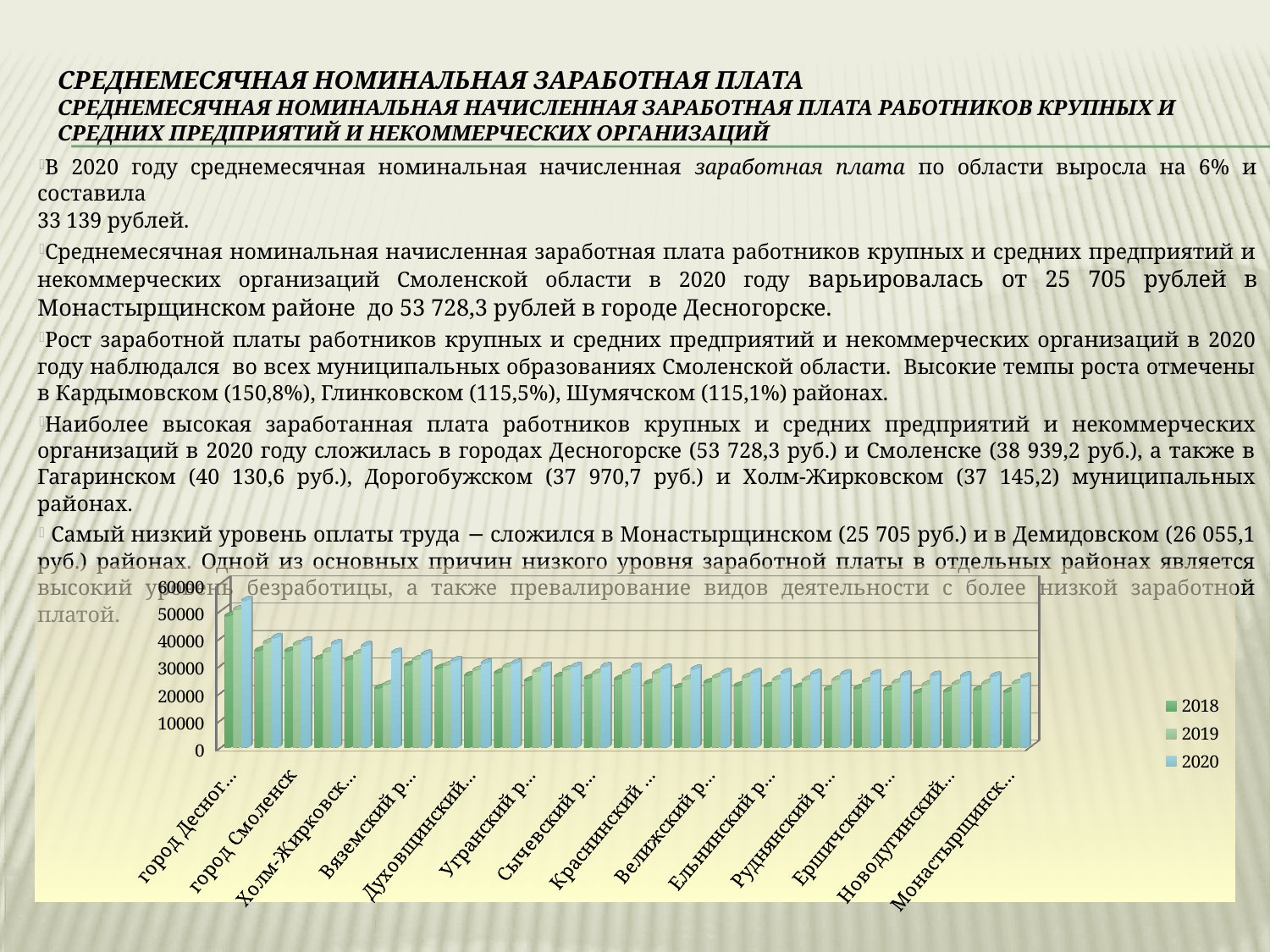
Do the bar heights generally rise or fall moving from left to right along the x axis? fall Is the 2020 value for Монастырщинский район greater or less than 30000? less Which category has the highest bars in the chart? город Десногорск Which years are listed in the chart legend? 2018, 2019, 2020 Is the 2020 value for город Десногорск greater or less than 50000? greater Is the 2018 value for Монастырщинский район greater or less than 30000? less What is the highest value shown on the vertical axis of the chart? 60000 What kind of chart is shown on the slide? bar chart How many series does the chart legend list? 3 Which is larger in 2020: the value for город Десногорск or for город Смоленск? город Десногорск Which category has the lowest bars in the chart? Монастырщинский район